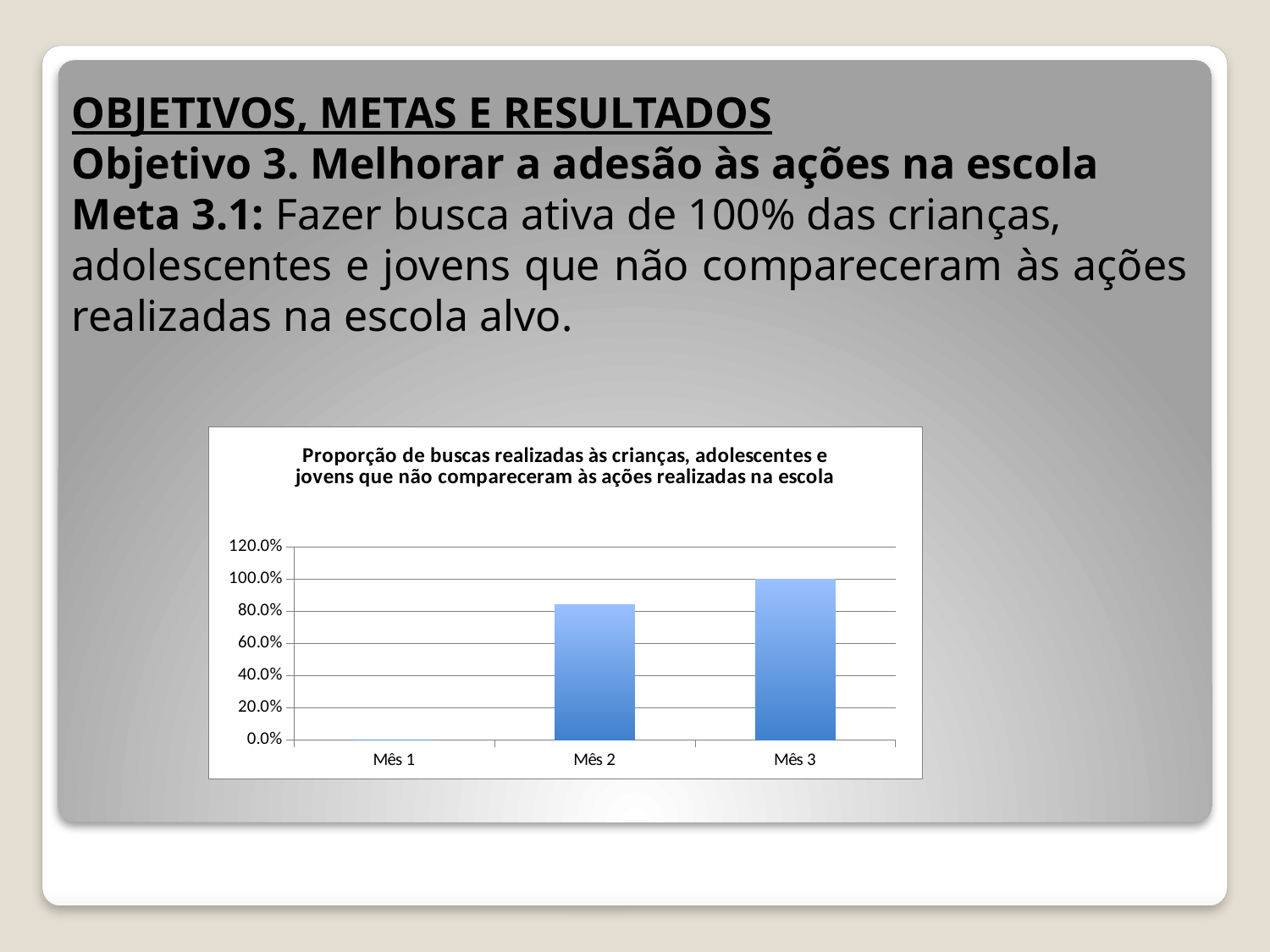
Which month has the highest value in the chart? Mês 3 Is the value for Mês 2 greater or less than 100.0%? less How many categories (months) are plotted on the x axis of the chart? 3 Is the value for Mês 2 greater or less than 60.0%? greater What is the highest tick value shown on the vertical axis of the chart? 120.0% What is the title of the chart? Proporção de buscas realizadas às crianças, adolescentes e jovens que não compareceram às ações realizadas na escola Which month has the lowest value in the chart? Mês 1 What kind of chart is shown on the slide? bar chart Is the value for Mês 1 greater or less than 20.0%? less What is the value for Mês 3 in the chart? 100.0% Which is larger, the value for Mês 2 or the value for Mês 3? Mês 3 Do the values rise or fall from Mês 1 to Mês 3? rise